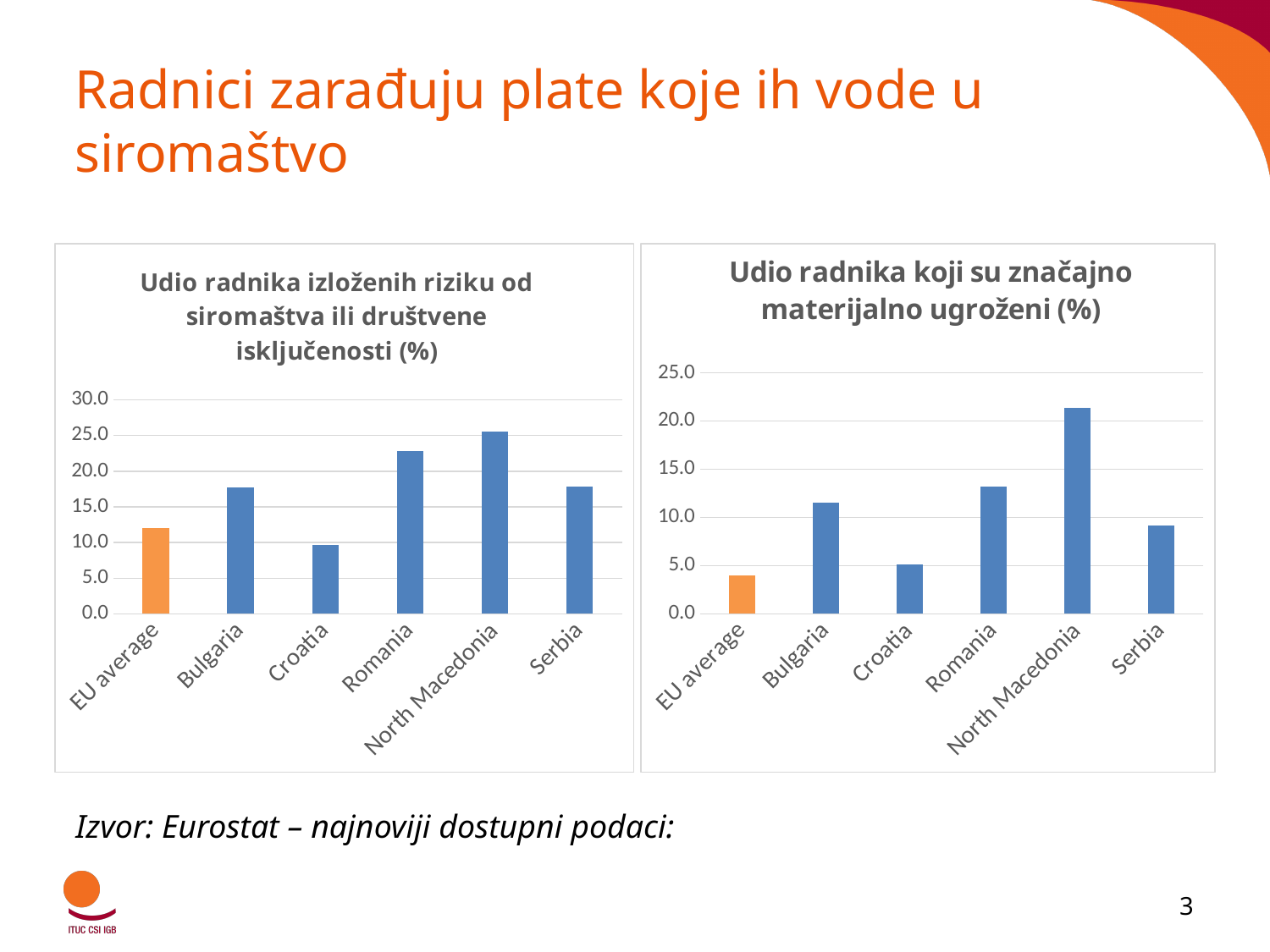
In the left chart (Udio radnika izloženih riziku od siromaštva ili društvene isključenosti), which category has the highest value? North Macedonia In the right chart, is the value for Serbia greater or less than 10.0? less In the left chart, is the value for Romania greater or less than 20.0? greater In the left chart, which is larger, the value for EU average or the value for Croatia? EU average In the right chart (Udio radnika koji su značajno materijalno ugroženi), which category has the lowest value? EU average In the left chart (Udio radnika izloženih riziku od siromaštva ili društvene isključenosti), which category has the lowest value? Croatia How many categories are shown on the x axis of the right chart? 6 In the right chart, is the value for North Macedonia greater or less than 20.0? greater In the right chart (Udio radnika koji su značajno materijalno ugroženi), which category has the highest value? North Macedonia In the right chart, which is larger, the value for Romania or the value for Bulgaria? Romania What type of chart is the left chart? Bar chart